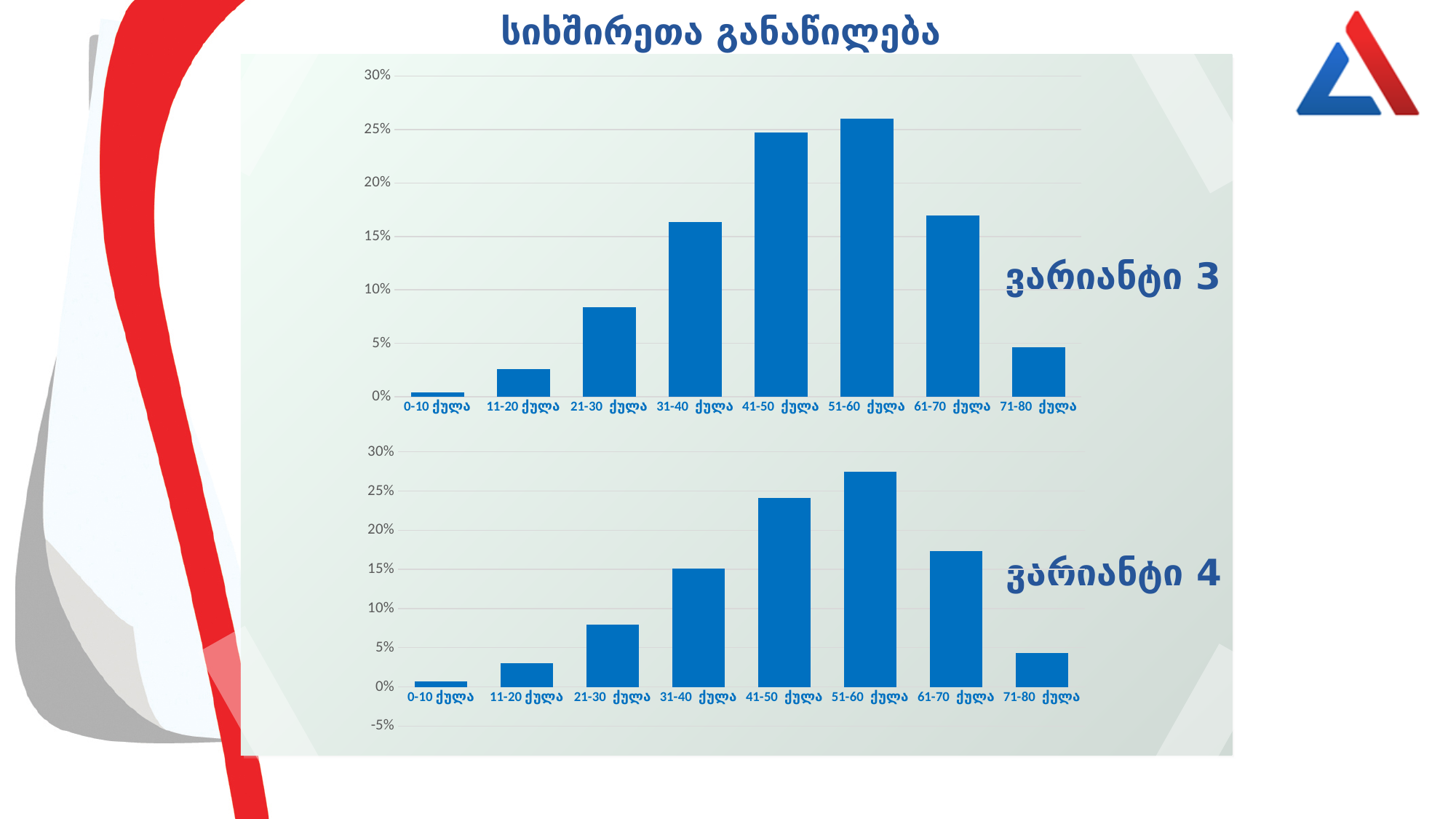
In the top chart (ვარიანტი 3), which category has the lowest value? 0-10 ქულა What is the title shown above the charts on the slide? სიხშირეთა განაწილება In the bottom chart (ვარიანტი 4), is the value for 61-70 ქულა greater or less than 15%? greater In the bottom chart (ვარიანტი 4), which category has the lowest value? 0-10 ქულა In the top chart (ვარიანტი 3), is the value for 71-80 ქულა greater or less than 5%? less In the bottom chart (ვარიანტი 4), which category has the highest value? 51-60 ქულა How many categories are shown on the x axis of the bottom chart (ვარიანტი 4)? 8 In the top chart (ვარიანტი 3), is the value for 31-40 ქულა greater or less than 15%? greater In the top chart (ვარიანტი 3), which category has the highest value? 51-60 ქულა In the top chart (ვარიანტი 3), which is larger: the value for 21-30 ქულა or the value for 71-80 ქულა? 21-30 ქულა What kind of chart is the top chart (ვარიანტი 3)? bar chart